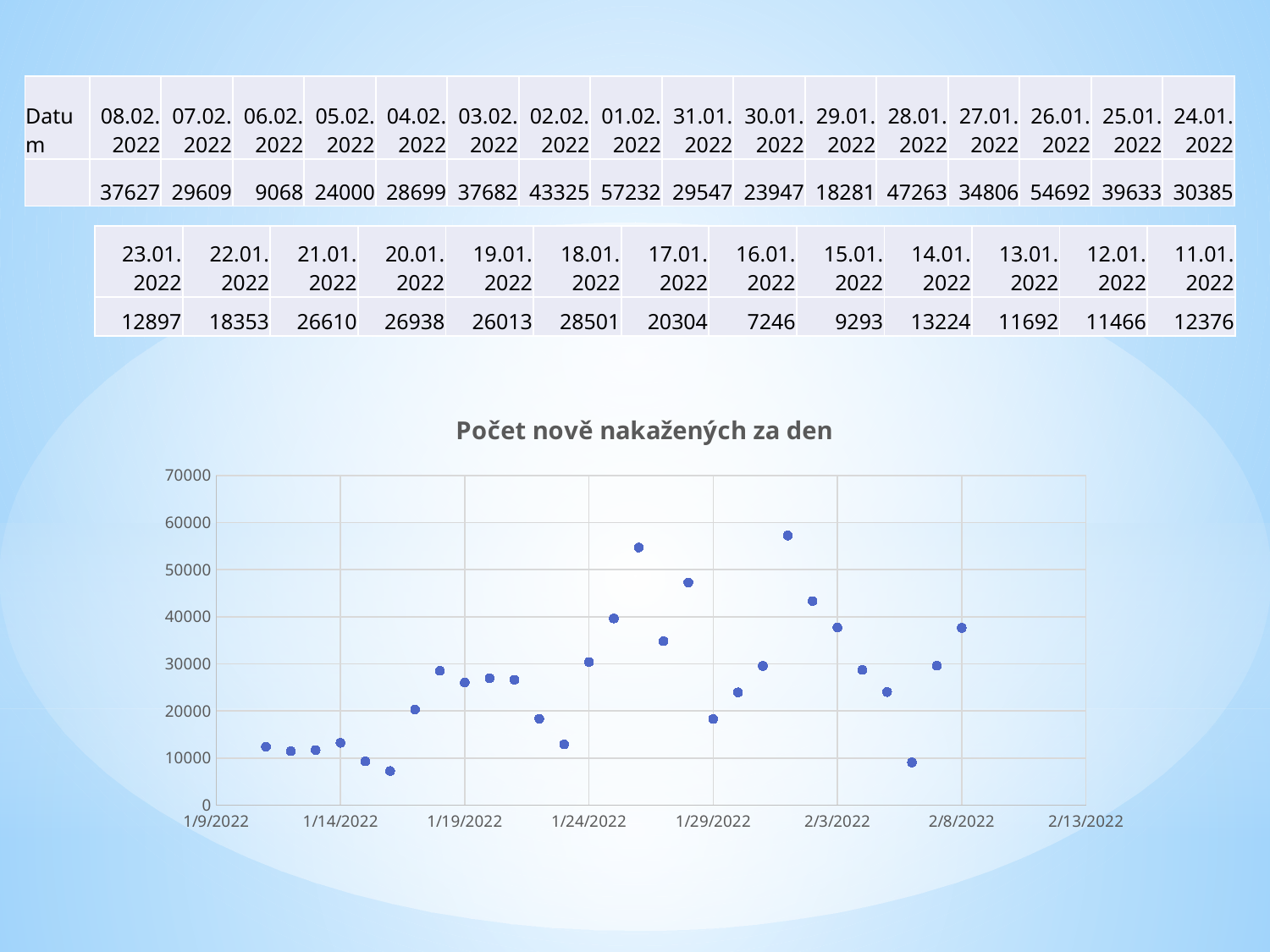
Which is larger, the value for 2/3/2022 or the value for 1/29/2022? 2/3/2022 Is the value for 1/29/2022 greater or less than 20000? less On which date does the chart reach its highest value? 01.02.2022 What is the title of the chart? Počet nově nakažených za den What is the maximum value shown on the vertical axis of the chart? 70000 What is the difference between the highest and lowest values in the chart? 49986 On which date does the chart reach its lowest value? 16.01.2022 What is the highest value plotted in the chart? 57232 Is the value for 2/3/2022 greater or less than 30000? greater What is the lowest value plotted in the chart? 7246 How many data points are plotted in the chart? 29 What type of chart is shown on the slide? scatter chart